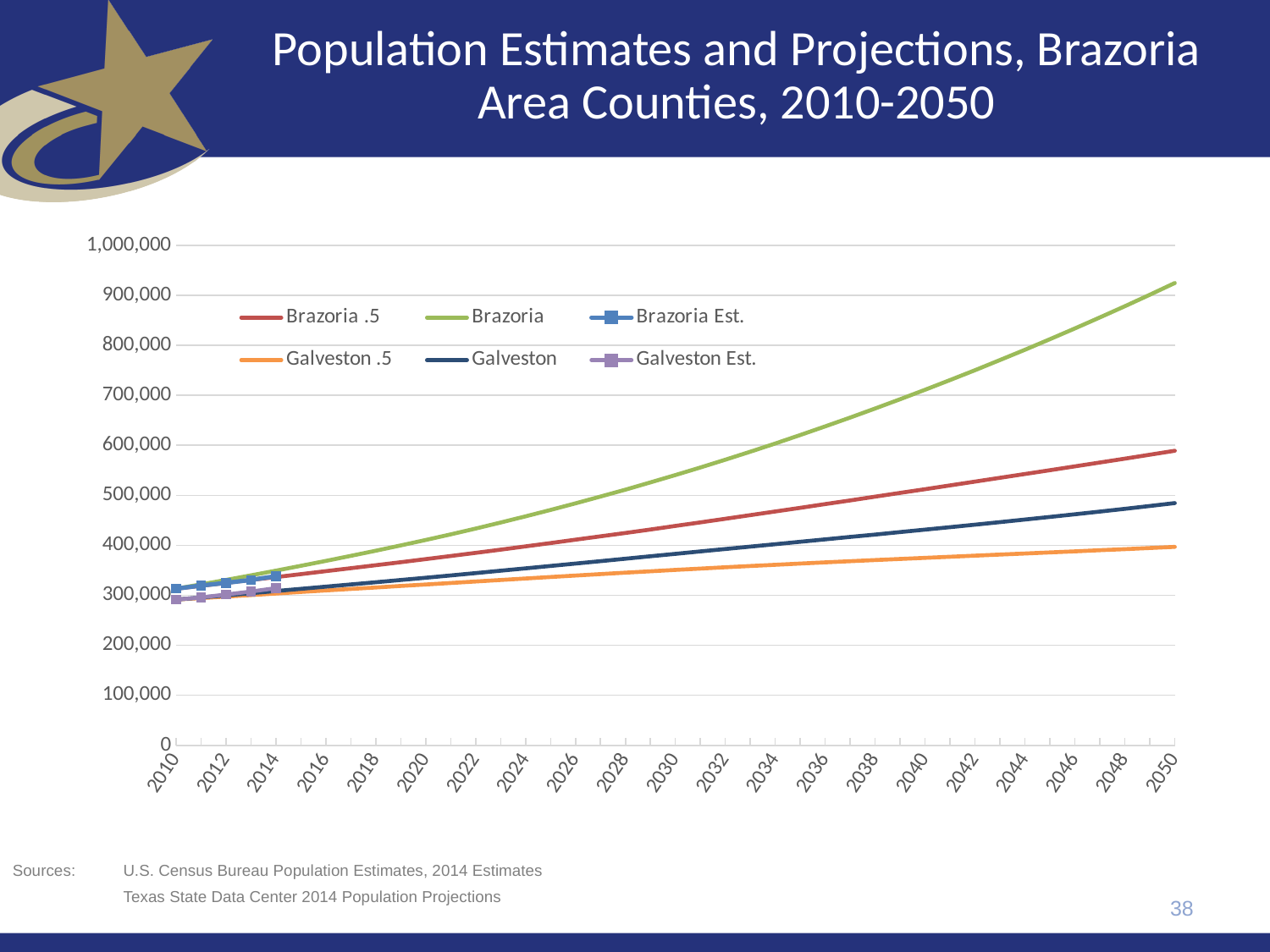
What is the title of the chart? Population Estimates and Projections, Brazoria Area Counties, 2010-2050 How many series does the legend list? 6 Does the Brazoria series rise or fall from 2010 to 2050? rise Which series has the highest value in 2050? Brazoria What kind of chart is shown on the slide? line chart What is the highest value shown on the vertical axis? 1,000,000 Which series has the lowest value in 2050? Galveston .5 Is the value for Brazoria in 2050 greater or less than 800,000? greater In 2050, which is larger: Brazoria .5 or Galveston? Brazoria .5 Is the value for Galveston in 2050 greater or less than 400,000? greater Is the value for Brazoria .5 in 2050 greater or less than 500,000? greater